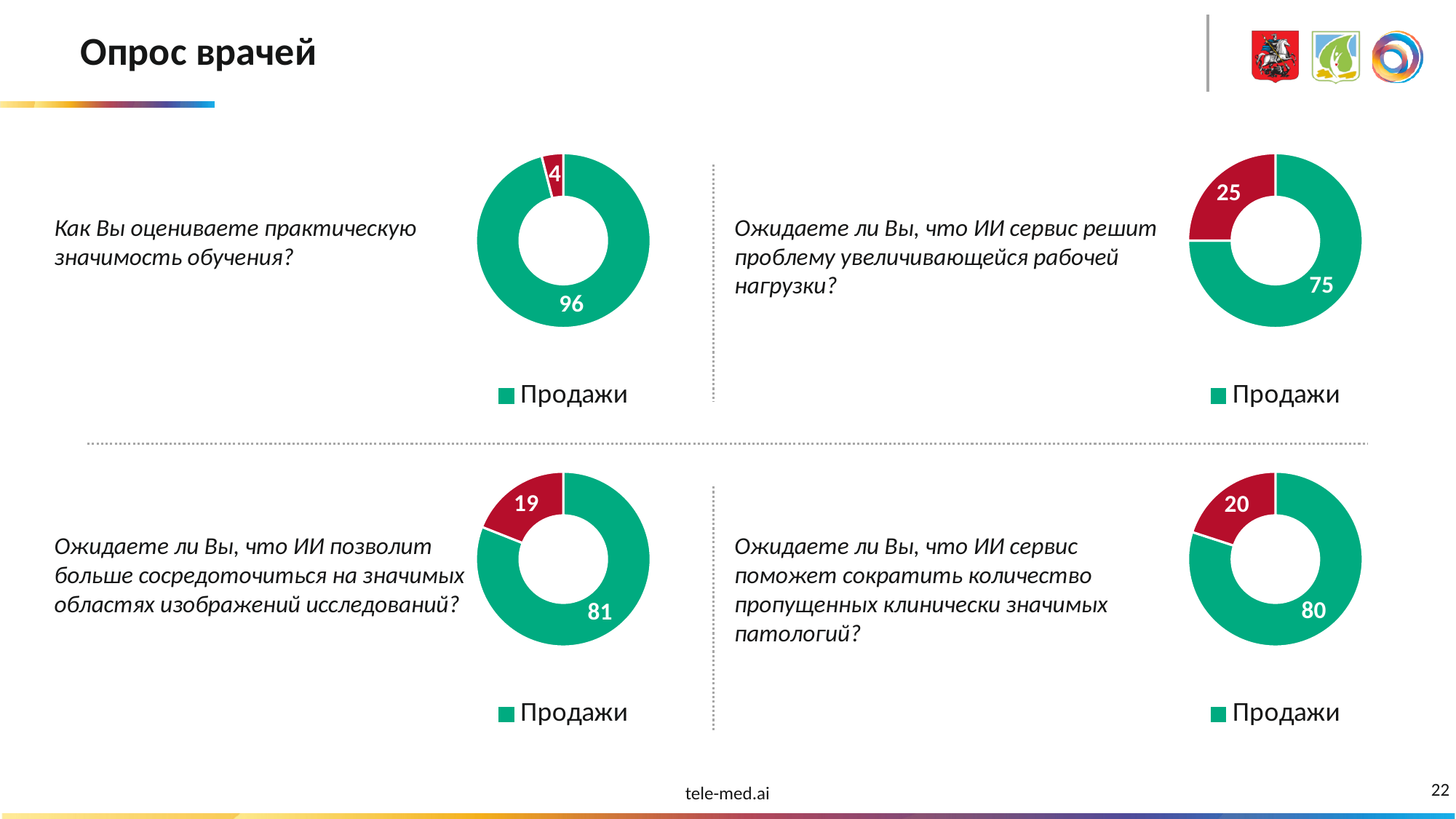
What type of chart is used in the top-left position on the slide? donut (pie) chart In the bottom-left donut chart, what is the difference between the green slice and the red slice? 62 How many entries does the legend of the bottom-left chart list? 1 In the bottom-left donut chart, what value is shown on the red slice? 19 What is the legend entry shown under the top-right chart? Продажи In the top-left donut chart, what value is shown on the green slice? 96 In the top-left donut chart, what value is shown on the red slice? 4 In the top-right donut chart, which slice is larger, the green one or the red one? the green one In the top-right donut chart, what value is shown on the green slice? 75 How many slices does the bottom-right donut chart have? 2 In the top-right donut chart, what value is shown on the red slice? 25 In the bottom-right donut chart, what value is shown on the green slice? 80